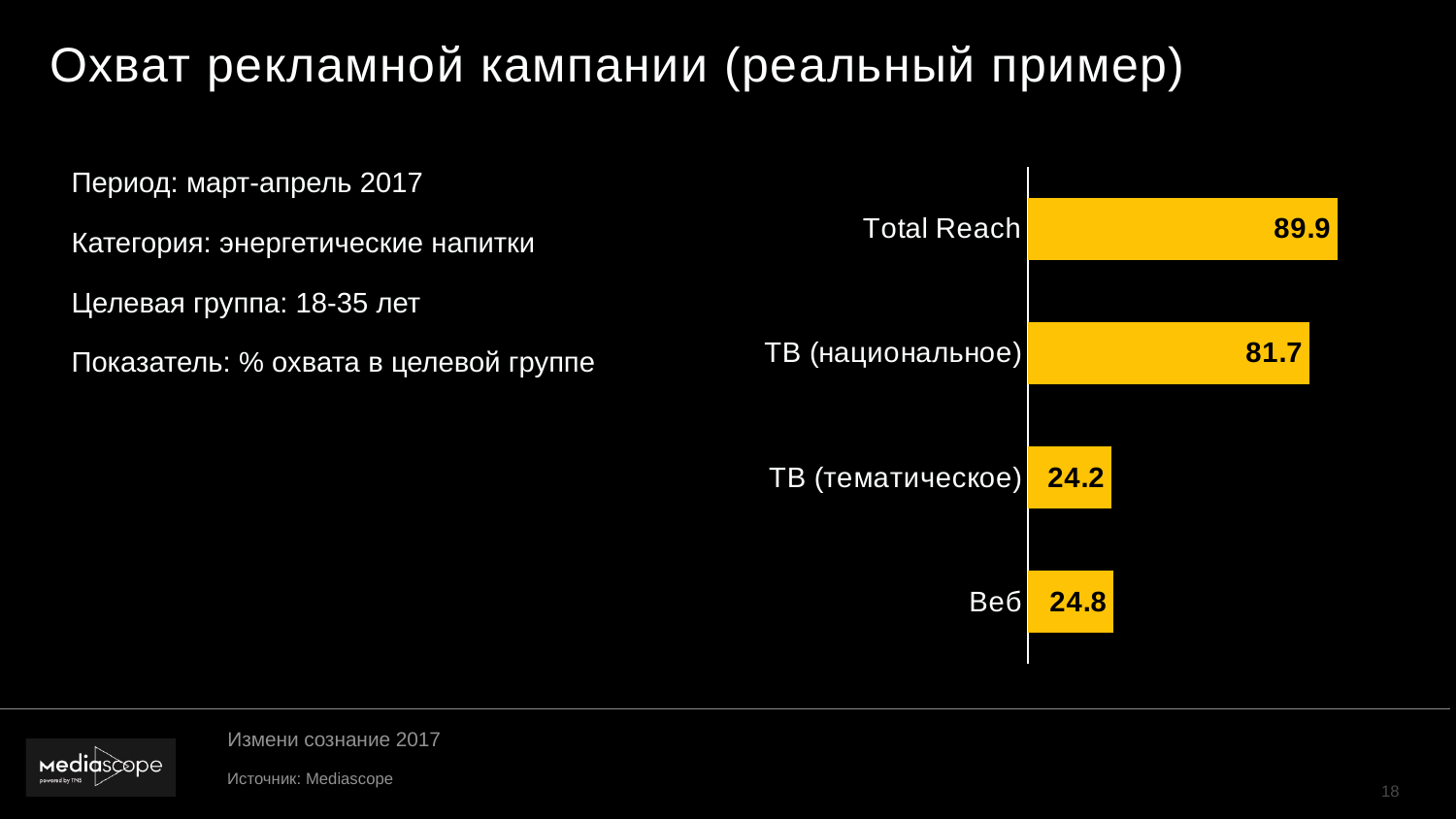
Which is larger, ТВ (национальное) or Веб? ТВ (национальное) What is the difference between Total Reach and ТВ (национальное)? 8.2 What is the value for ТВ (тематическое)? 24.2 How many categories are shown in the chart? 4 What kind of chart is shown on the slide? Bar chart Which category has the lowest value? ТВ (тематическое) Which category has the highest value? Total Reach What is the difference between ТВ (национальное) and ТВ (тематическое)? 57.5 What is the value for ТВ (национальное)? 81.7 What colour are the bars in the chart? Yellow What is the value for Веб? 24.8 What is the value for Total Reach? 89.9